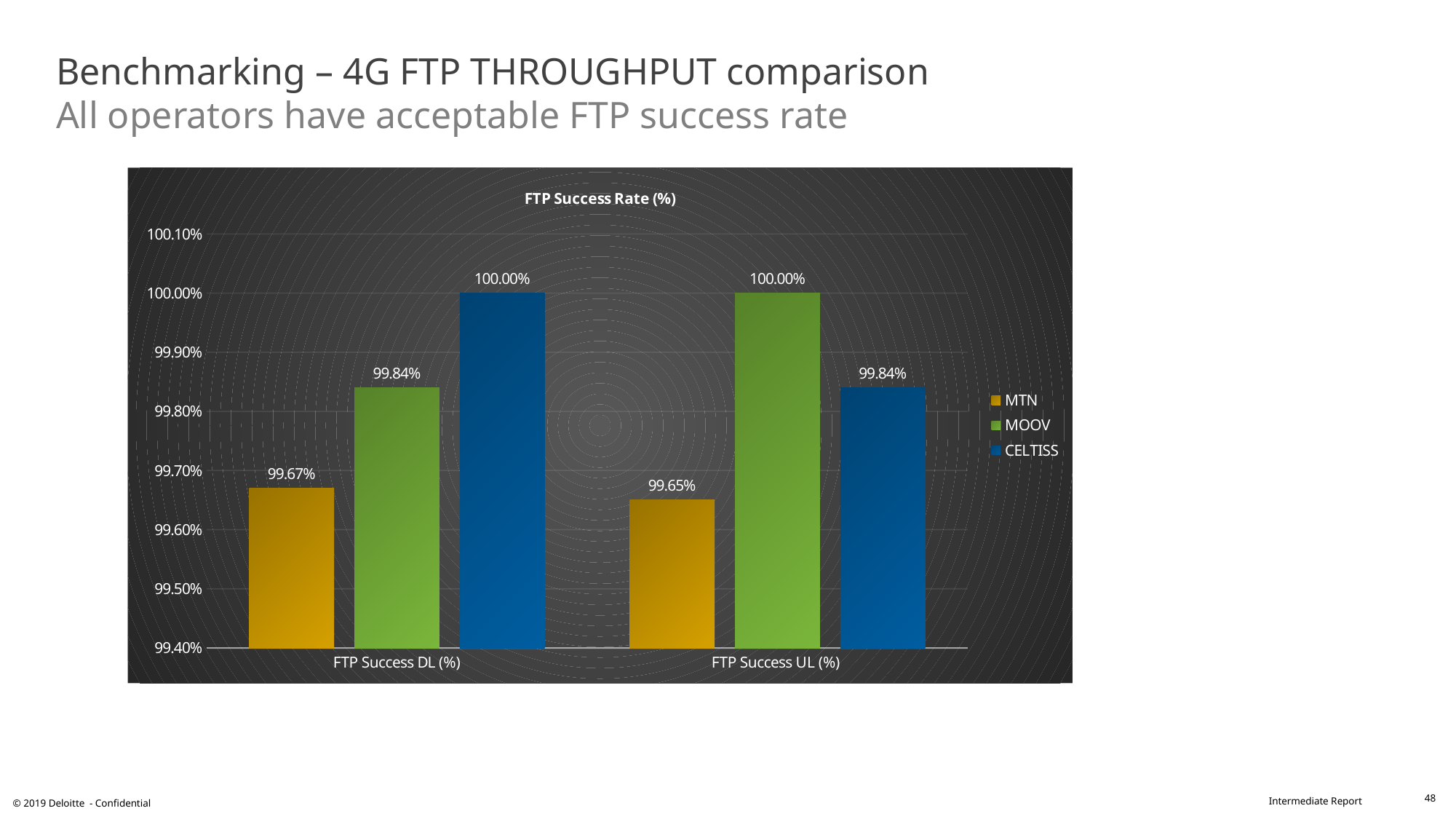
How many categories are shown on the x axis? 2 Which is larger: MOOV's FTP Success DL (%) or MOOV's FTP Success UL (%)? FTP Success UL (%) Which operator has the lowest FTP Success UL (%)? MTN What kind of chart is shown on the slide? Bar chart What is the title of the chart? FTP Success Rate (%) What is the difference between CELTISS and MTN for FTP Success DL (%)? 0.33% Is the value for MTN in FTP Success UL (%) greater or less than 99.70%? less What is the FTP Success UL (%) value for MOOV? 100.00% Which operator has the highest FTP Success DL (%)? CELTISS How many series does the legend list? 3 What is the FTP Success UL (%) value for CELTISS? 99.84% What is the FTP Success DL (%) value for MTN? 99.67%